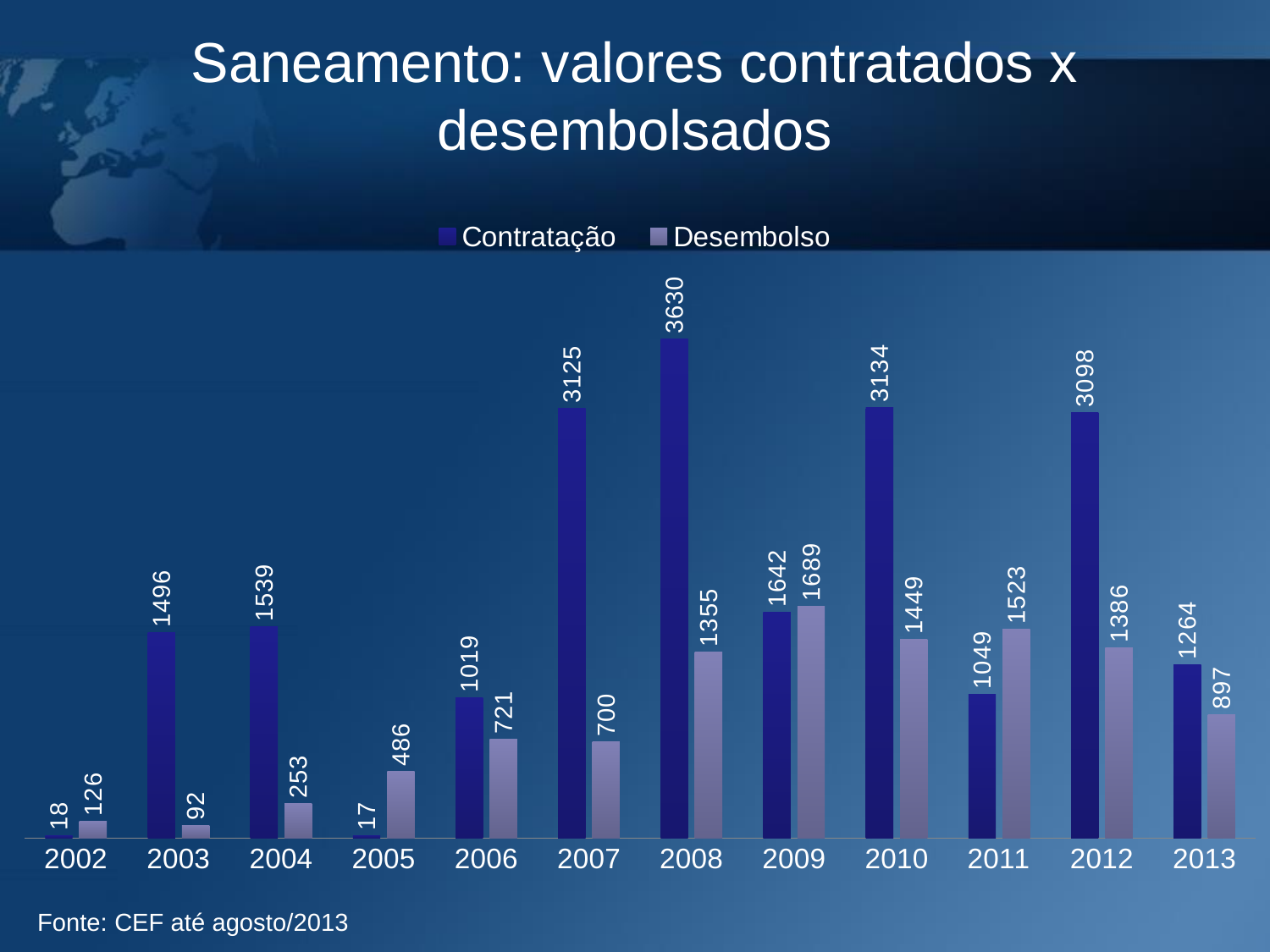
What kind of chart is shown on the slide? Bar chart Which year has the lowest Desembolso value? 2003 Does the Desembolso value rise or fall from 2011 to 2013? Fall What is the Contratação value for 2005? 17 What is the Contratação value for 2008? 3630 What is the difference between Contratação and Desembolso in 2008? 2275 How many years are shown on the x axis? 12 In 2009, which is larger: Contratação or Desembolso? Desembolso Which year has the highest Contratação value? 2008 What is the Desembolso value for 2011? 1523 What is the source cited below the chart? CEF até agosto/2013 How many series does the legend list? 2